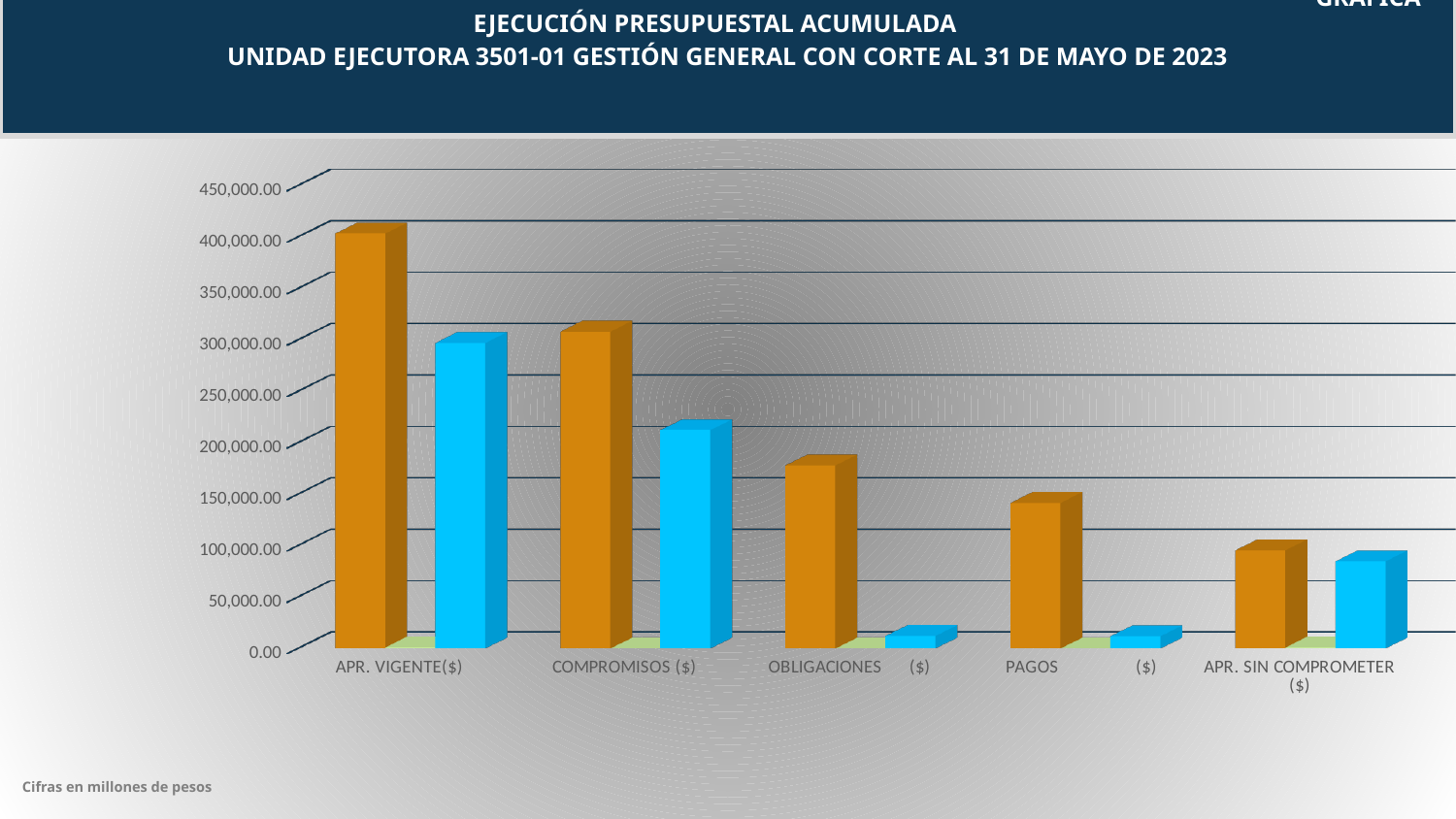
According to the note at the bottom of the slide, in what units are the figures expressed? millones de pesos Is the blue bar for APR. VIGENTE($) greater or less than 350,000.00? less Which category has the tallest orange bar? APR. VIGENTE($) Is the blue bar for OBLIGACIONES ($) greater or less than 50,000.00? less Is the orange bar for COMPROMISOS ($) greater or less than 250,000.00? greater Which category has the shortest orange bar? APR. SIN COMPROMETER ($) What kind of chart is shown on the slide? bar chart For APR. VIGENTE($), which bar is taller, the orange one or the blue one? the orange one Do the orange bars generally rise or fall from left to right across the categories? fall How many categories are shown along the x axis of the chart? 5